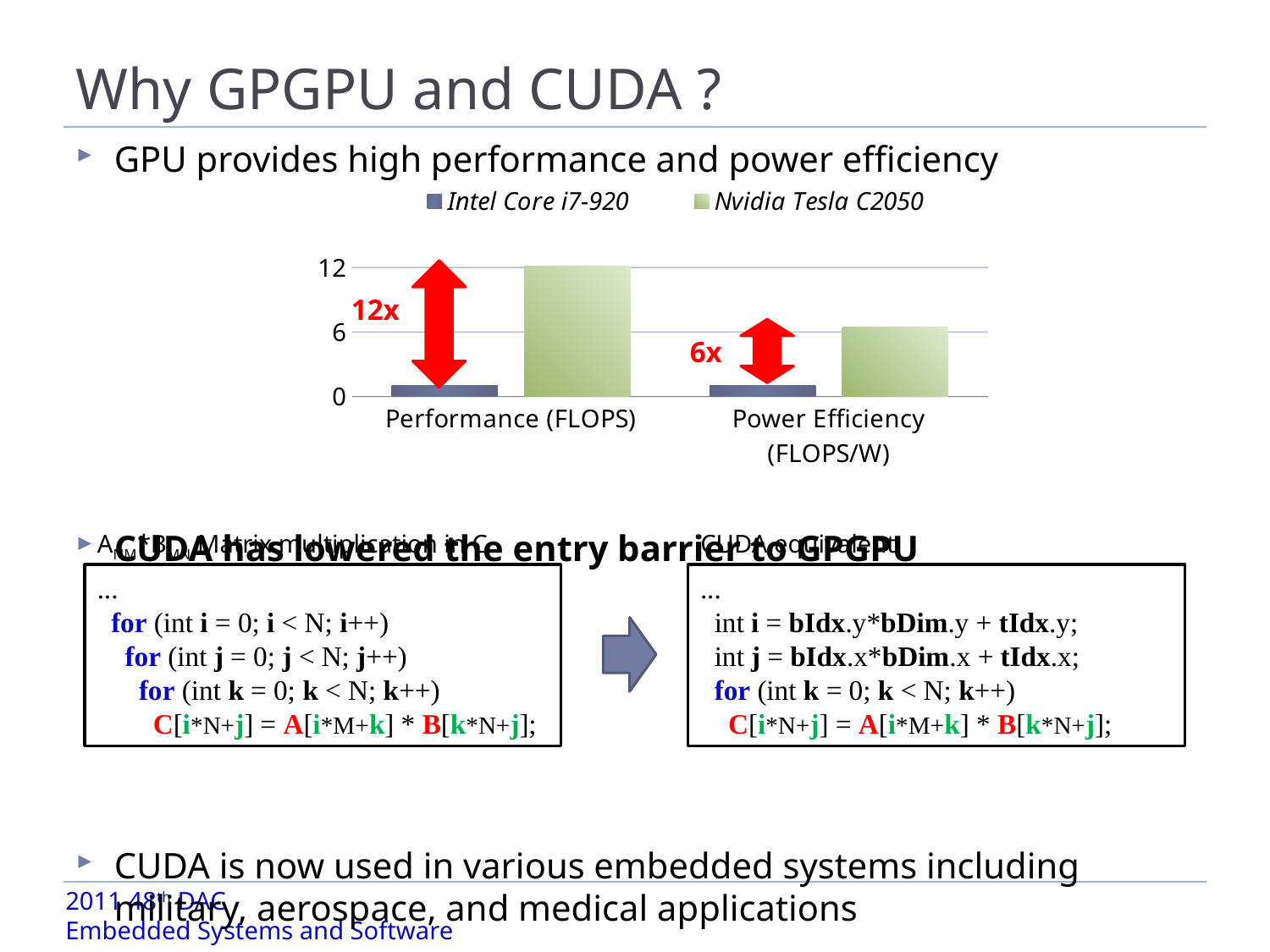
Is the value for Intel Core i7-920 in Power Efficiency (FLOPS/W) greater or less than 6? less What kind of chart is shown on the slide? bar chart Which category has the highest bar in the chart? Performance (FLOPS) How many categories are shown on the x axis of the chart? 2 What multiplier label is shown next to the red arrow for Performance (FLOPS)? 12x Which series has the higher bar for Power Efficiency (FLOPS/W)? Nvidia Tesla C2050 Is the value for Intel Core i7-920 in Performance (FLOPS) greater or less than 6? less Which two series are listed in the chart legend? Intel Core i7-920 and Nvidia Tesla C2050 Is the value for Nvidia Tesla C2050 in Power Efficiency (FLOPS/W) greater or less than 12? less Which series has the higher bar for Performance (FLOPS)? Nvidia Tesla C2050 How many series does the chart legend list? 2